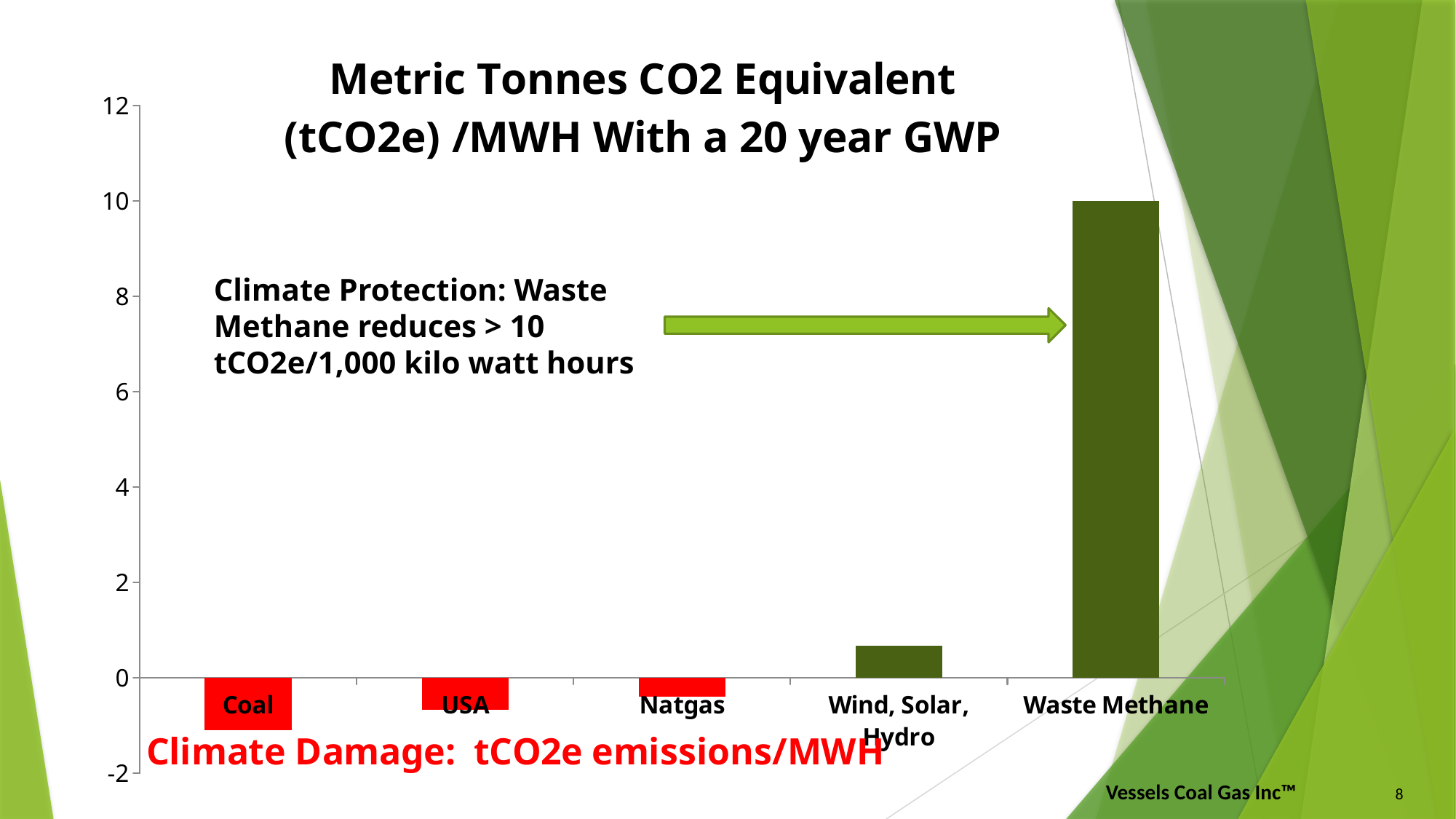
Which category has the highest value in the chart? Waste Methane Which is larger, the value for Waste Methane or the value for Wind, Solar, Hydro? Waste Methane How many categories are plotted on the x axis of the chart? 5 What is the title of the chart? Metric Tonnes CO2 Equivalent (tCO2e) /MWH With a 20 year GWP Is the value for Coal greater or less than 0? less Is the value for Wind, Solar, Hydro greater or less than 2? less What is the value for Waste Methane in the chart? 10 Which is larger, the value for Coal or the value for USA? USA Is the value for Waste Methane greater or less than 8? greater Which category has the lowest value in the chart? Coal What kind of chart is shown on the slide? bar chart How many categories in the chart have negative values? 3